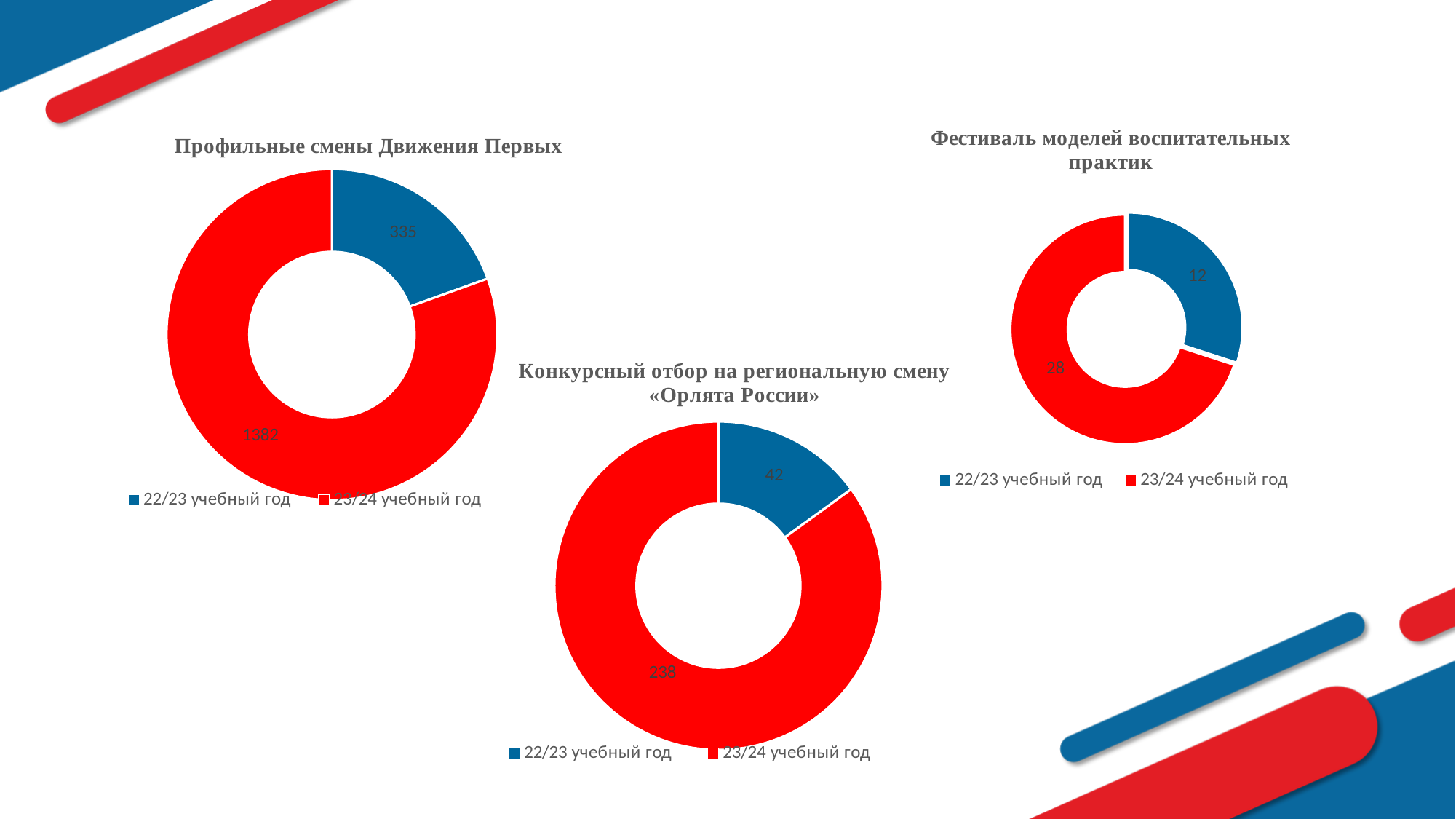
In the chart titled «Фестиваль моделей воспитательных практик», what is the value for 22/23 учебный год? 12 In the chart titled «Конкурсный отбор на региональную смену «Орлята России»», what share of the total does 22/23 учебный год represent? 15% In the chart titled «Профильные смены Движения Первых», what is the value for 23/24 учебный год? 1382 In the chart titled «Конкурсный отбор на региональную смену «Орлята России»», which category has the smallest value? 22/23 учебный год What type of chart is used for «Профильные смены Движения Первых»? Donut (pie) chart In the chart titled «Конкурсный отбор на региональную смену «Орлята России»», what is the value for 23/24 учебный год? 238 How many entries does the legend of the chart titled «Фестиваль моделей воспитательных практик» list? 2 In the chart titled «Профильные смены Движения Первых», what is the value for 22/23 учебный год? 335 In the chart titled «Фестиваль моделей воспитательных практик», what share of the total does 23/24 учебный год represent? 70% In the chart titled «Конкурсный отбор на региональную смену «Орлята России»», what is the difference between the 23/24 and 22/23 values? 196 In the chart titled «Профильные смены Движения Первых», what is the difference between the 23/24 and 22/23 values? 1047 In the chart titled «Фестиваль моделей воспитательных практик», which year has the larger value? 23/24 учебный год